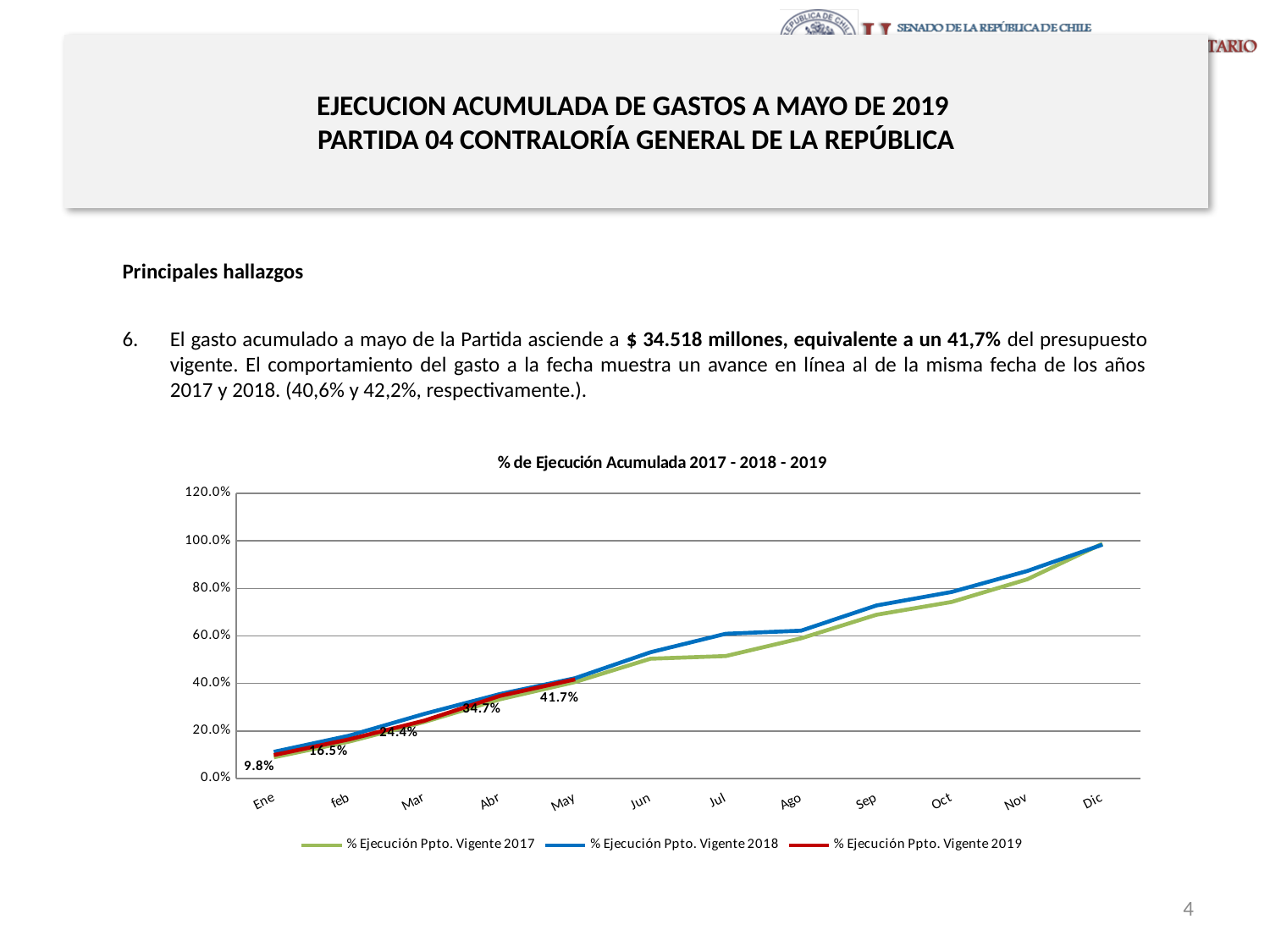
What is the value of % Ejecución Ppto. Vigente 2019 for Ene? 9.8% Do the values of the series rise or fall from Ene to Dic? rise What is the value of % Ejecución Ppto. Vigente 2019 for Mar? 24.4% In Jul, which series has the larger value: % Ejecución Ppto. Vigente 2018 or % Ejecución Ppto. Vigente 2017? % Ejecución Ppto. Vigente 2018 Is the value for % Ejecución Ppto. Vigente 2017 in Jul greater or less than 60.0%? less What kind of chart is shown on the slide? line chart How many series does the legend of the chart list? 3 Which month has the highest labelled value for % Ejecución Ppto. Vigente 2019? May What is the title of the chart? % de Ejecución Acumulada 2017 - 2018 - 2019 How many months are shown along the x axis of the chart? 12 What is the difference between the % Ejecución Ppto. Vigente 2019 values for Abr and Mar? 10.3% What is the value of % Ejecución Ppto. Vigente 2019 for May? 41.7%